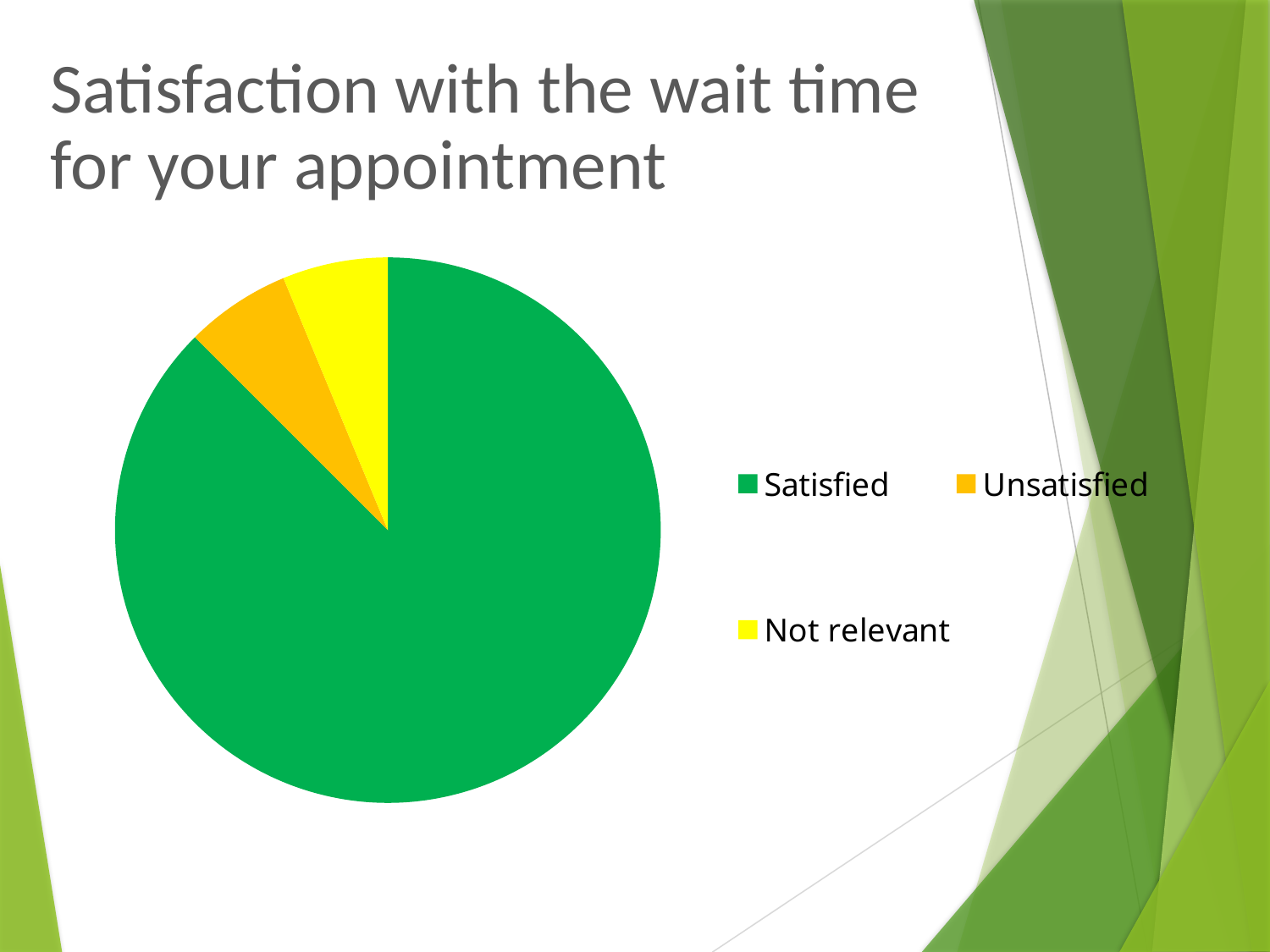
How many entries does the legend list? 3 What colour is the Satisfied slice? Green Which is larger, the Satisfied slice or the Not relevant slice? Satisfied Is the Satisfied slice greater or less than half of the pie? greater What kind of chart is shown on the slide? Pie chart How many slices does the pie chart have? 3 Is the Unsatisfied slice greater or less than a quarter of the pie? less What is the title of the chart? Satisfaction with the wait time for your appointment Which is larger, the Satisfied slice or the Unsatisfied slice? Satisfied Which category has the largest slice of the pie? Satisfied